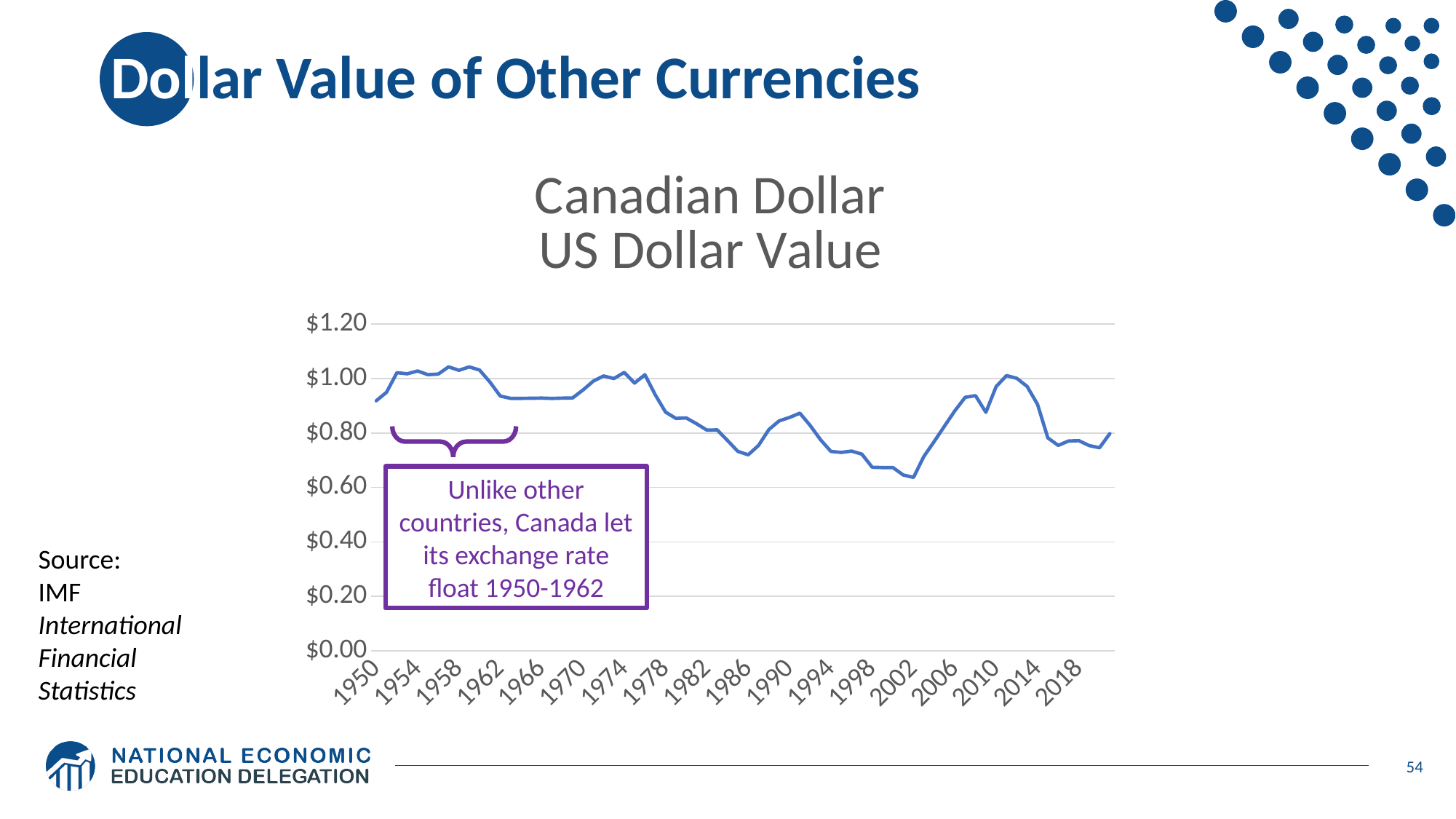
Is the value for 1966 greater or less than $0.80? greater What is the title of the chart? Canadian Dollar US Dollar Value Is the value for 1958 greater or less than $1.00? greater How many year labels are shown on the x axis? 18 Around which labelled year is the value lowest? 2002 Does the value rise or fall between 1974 and 1986? Fall Does the value rise or fall between 2002 and 2010? Rise What kind of chart is shown on the slide? Line chart Is the value for 2010 greater or less than $0.80? greater According to the annotation, during which years did Canada let its exchange rate float? 1950-1962